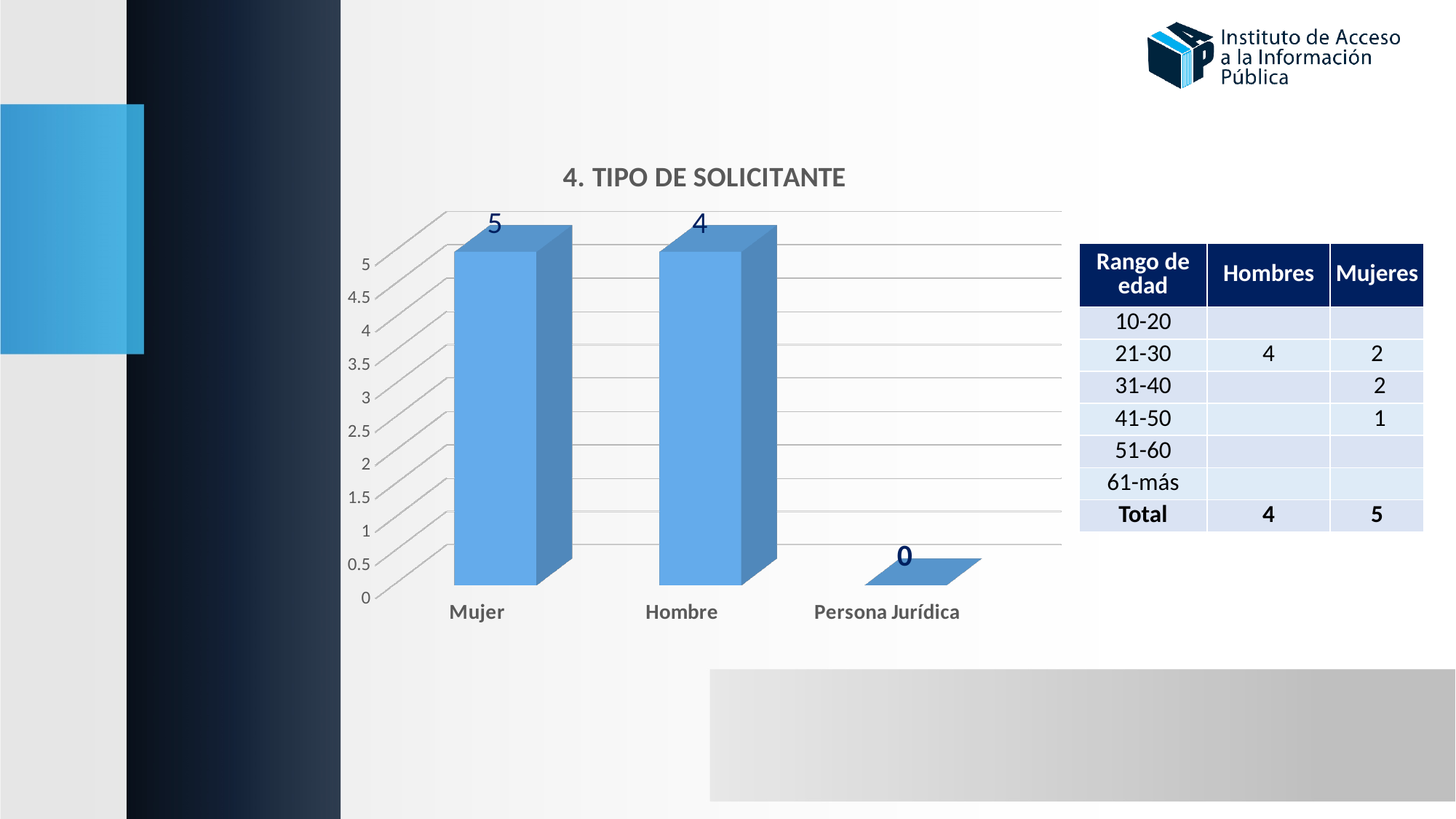
Which is larger, the value for Hombre or the value for Persona Jurídica? Hombre What is the title of the chart? 4. TIPO DE SOLICITANTE What kind of chart is shown? bar chart What is the value for Persona Jurídica? 0 What is the value for Hombre? 4 What is the highest tick value shown on the vertical axis? 5 What is the difference between the values for Mujer and Hombre? 1 Do the values rise or fall from left to right along the x axis? fall How many categories are shown on the x axis? 3 Which category has the lowest value? Persona Jurídica Which category has the highest value? Mujer What is the value for Mujer? 5